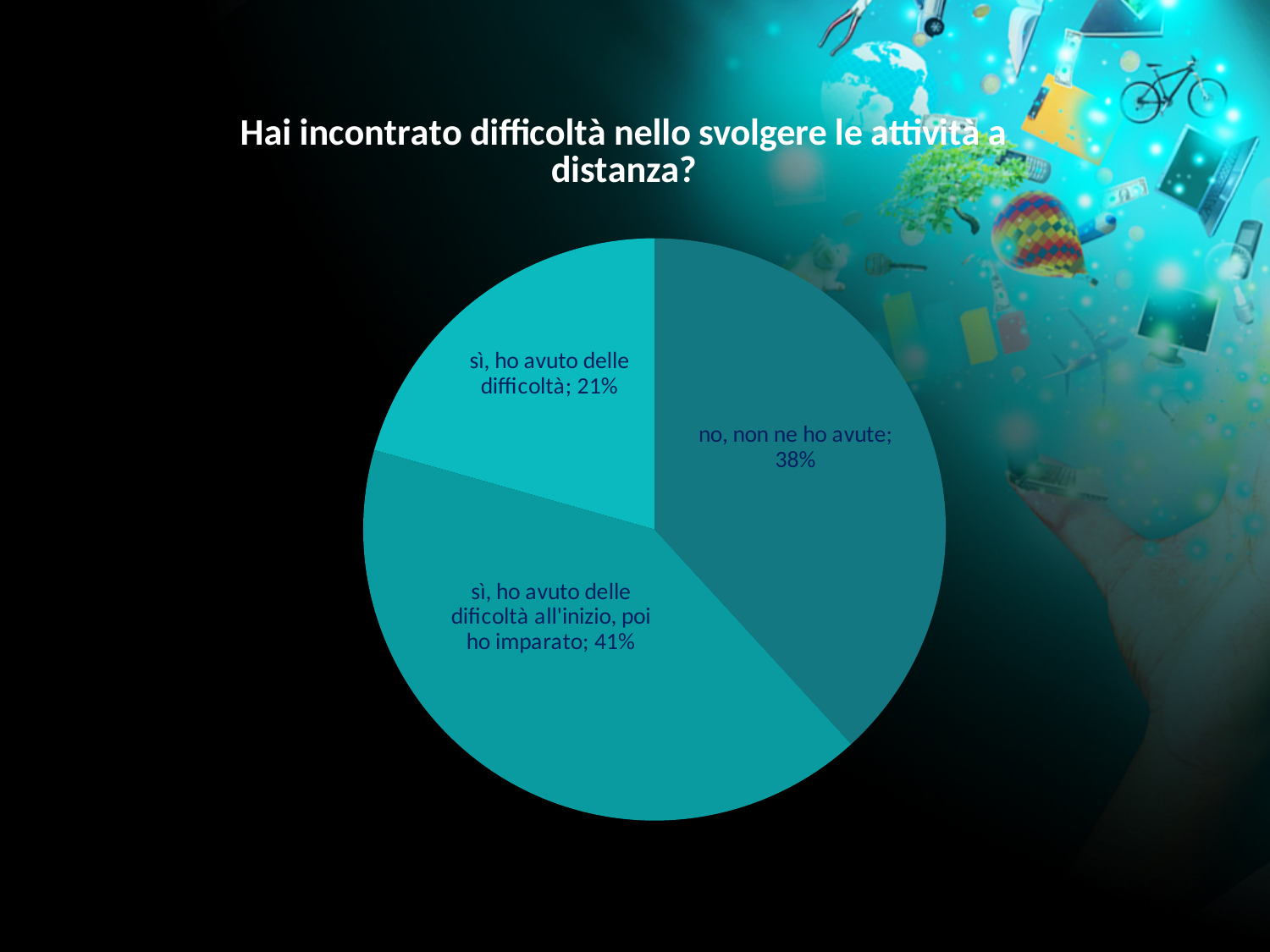
How many slices does the pie chart have? 3 What is the combined percentage of the two "sì" categories? 62% What kind of chart is shown on the slide? pie chart Which category has the smallest share of the pie? sì, ho avuto delle difficoltà What is the difference in percentage points between "no, non ne ho avute" and "sì, ho avuto delle difficoltà"? 17 What percentage is shown for "no, non ne ho avute"? 38% Which is larger: the share for "no, non ne ho avute" or the share for "sì, ho avuto delle difficoltà"? no, non ne ho avute What is the difference in percentage points between "sì, ho avuto delle dificoltà all'inizio, poi ho imparato" and "no, non ne ho avute"? 3 Which category has the largest share of the pie? sì, ho avuto delle dificoltà all'inizio, poi ho imparato What percentage is shown for "sì, ho avuto delle dificoltà all'inizio, poi ho imparato"? 41% What percentage is shown for "sì, ho avuto delle difficoltà"? 21% What is the title of the chart? Hai incontrato difficoltà nello svolgere le attività a distanza?